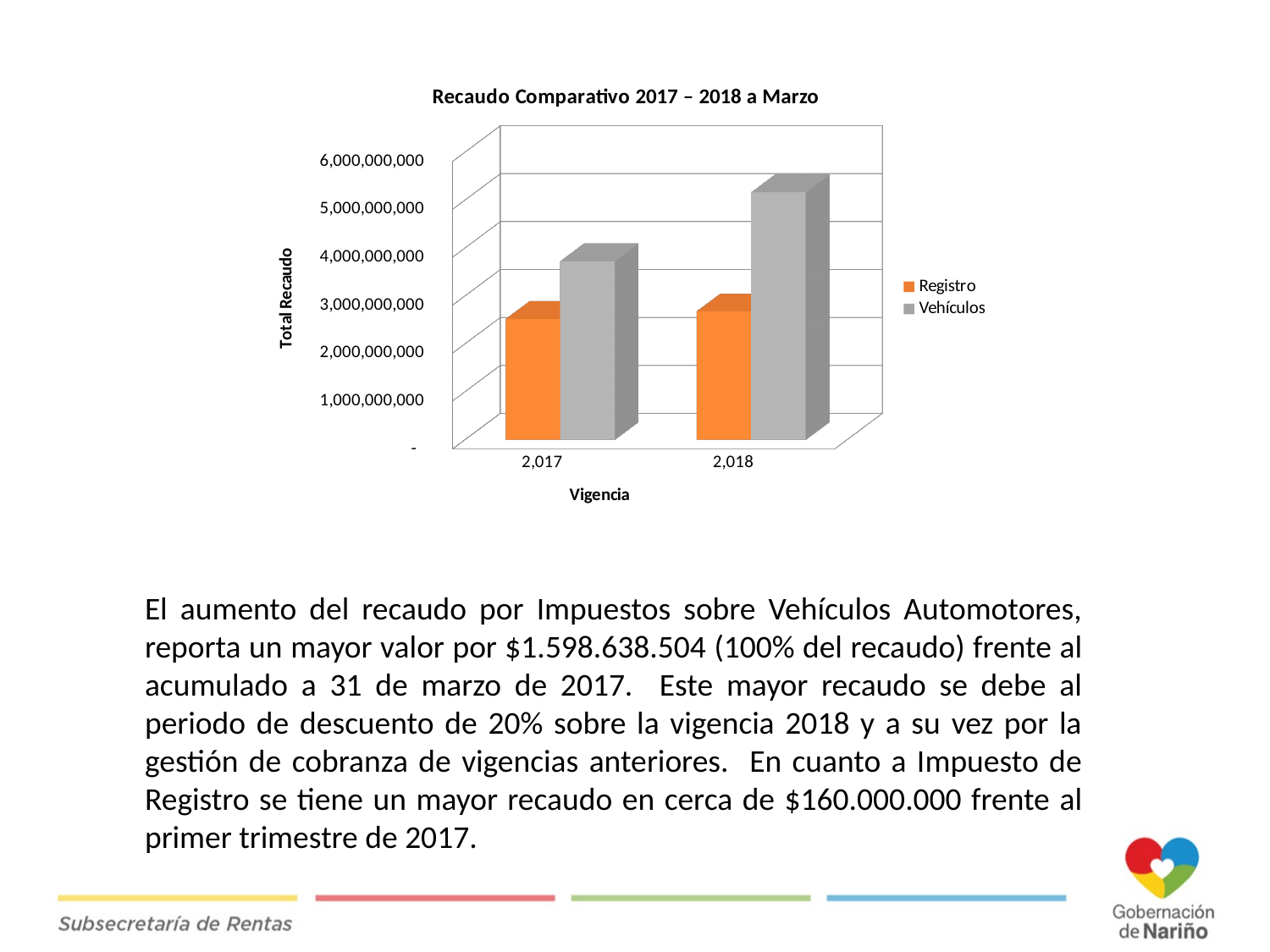
In 2,018, which is larger: Registro or Vehículos? Vehículos How many series does the chart legend list? 2 Is the value for Registro in 2,017 greater or less than 3,000,000,000? less Which series is shown in orange in the chart legend? Registro What is the title of the chart? Recaudo Comparativo 2017 – 2018 a Marzo Does the value for Vehículos rise or fall from 2,017 to 2,018? rise Is the value for Vehículos in 2,018 greater or less than 4,000,000,000? greater In 2,017, which is larger: Registro or Vehículos? Vehículos How many categories (vigencias) are shown on the x axis of the chart? 2 What kind of chart is shown on the slide? bar chart Which bar is the highest in the chart? Vehículos in 2,018 Is the value for Vehículos in 2,017 greater or less than 4,000,000,000? less